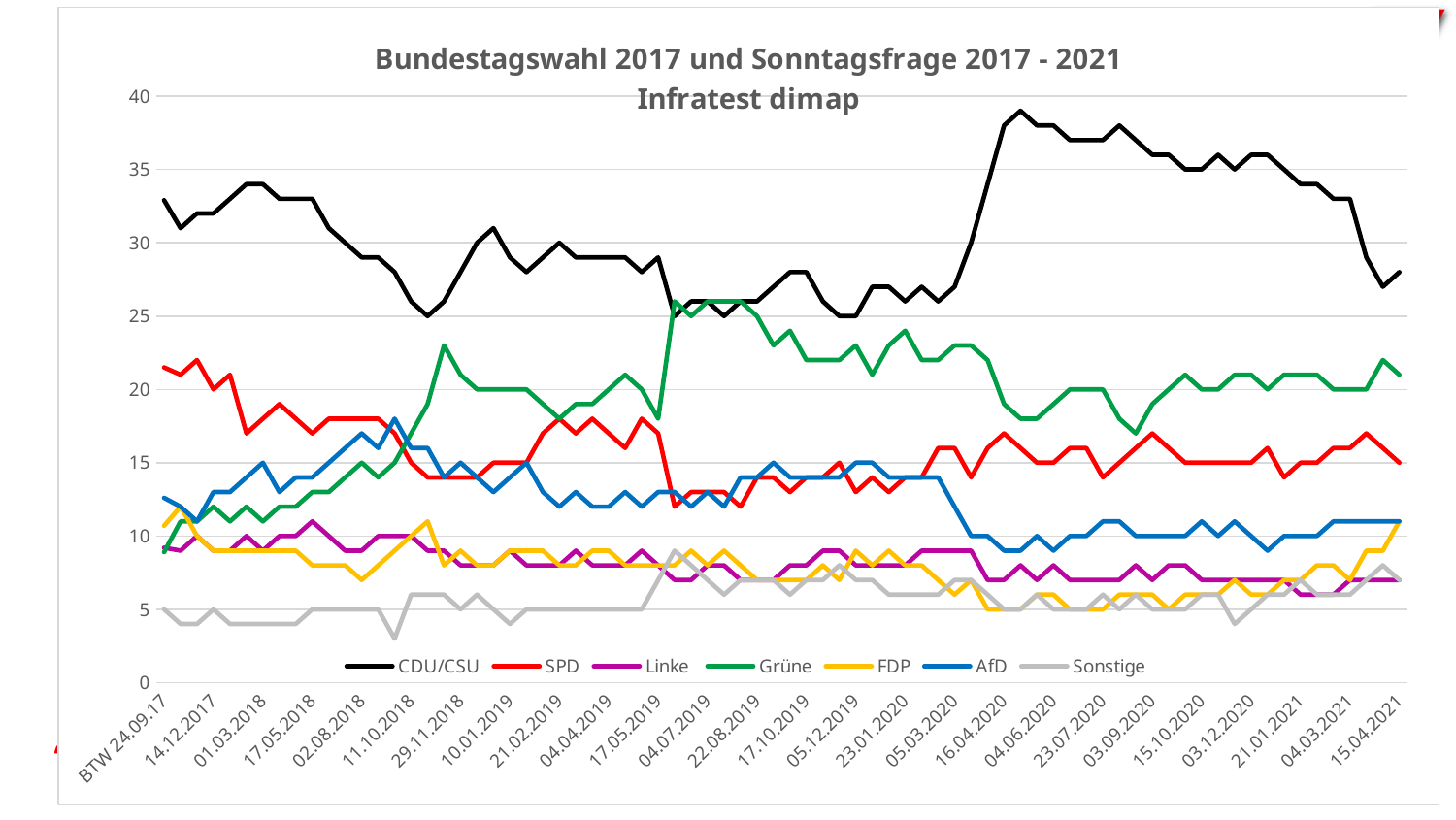
Does the CDU/CSU line rise or fall between 16.04.2020 and 15.04.2021? fall At BTW 24.09.17, which is larger: SPD or Grüne? SPD What kind of chart is shown on the slide? line chart Which series has the highest value at BTW 24.09.17? CDU/CSU At 15.04.2021, which is larger: Grüne or SPD? Grüne What is the title of the chart? Bundestagswahl 2017 und Sonntagsfrage 2017 - 2021 Infratest dimap Which series is drawn with the black line? CDU/CSU How many series does the legend list? 7 Is the value for CDU/CSU at 15.04.2021 greater or less than 30? less Is the value for CDU/CSU at 16.04.2020 greater or less than 35? greater Is the value for SPD at BTW 24.09.17 greater or less than 20? greater